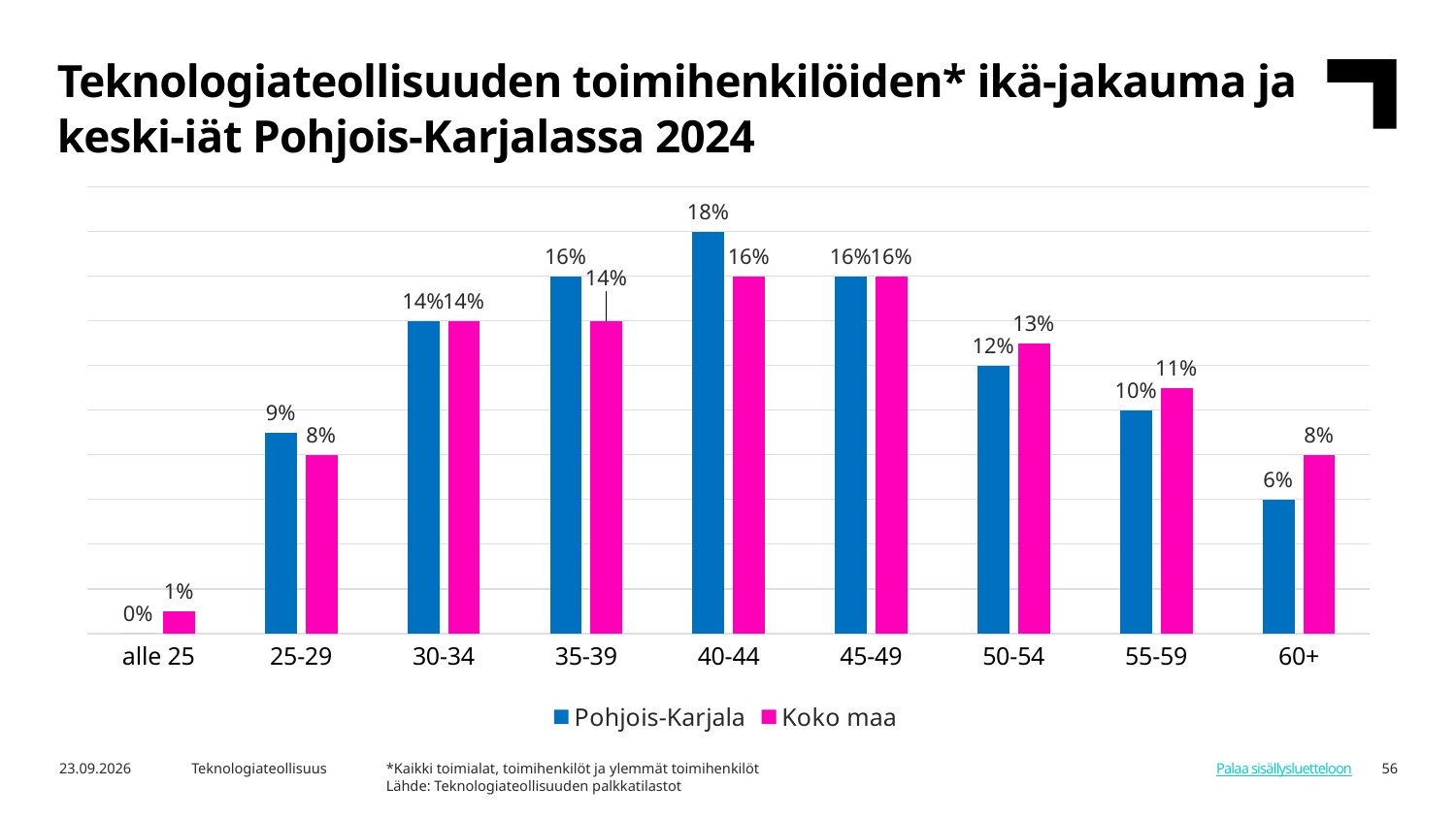
Do the Pohjois-Karjala values rise or fall from the 45-49 age group to the 60+ age group? Fall Which series is shown in pink in the legend? Koko maa What is the value for Pohjois-Karjala in the 25-29 age group? 9% What is the value for Koko maa in the 60+ age group? 8% How many age groups are shown on the x axis? 9 What is the value for Pohjois-Karjala in the 40-44 age group? 18% Which age group has the lowest value for Koko maa? alle 25 In the 50-54 age group, which series has the larger value, Pohjois-Karjala or Koko maa? Koko maa What kind of chart is shown on the slide? Bar chart What is the difference between the Pohjois-Karjala and Koko maa values in the 35-39 age group? 2% Which age group has the highest value for Pohjois-Karjala? 40-44 How many series does the legend list? 2